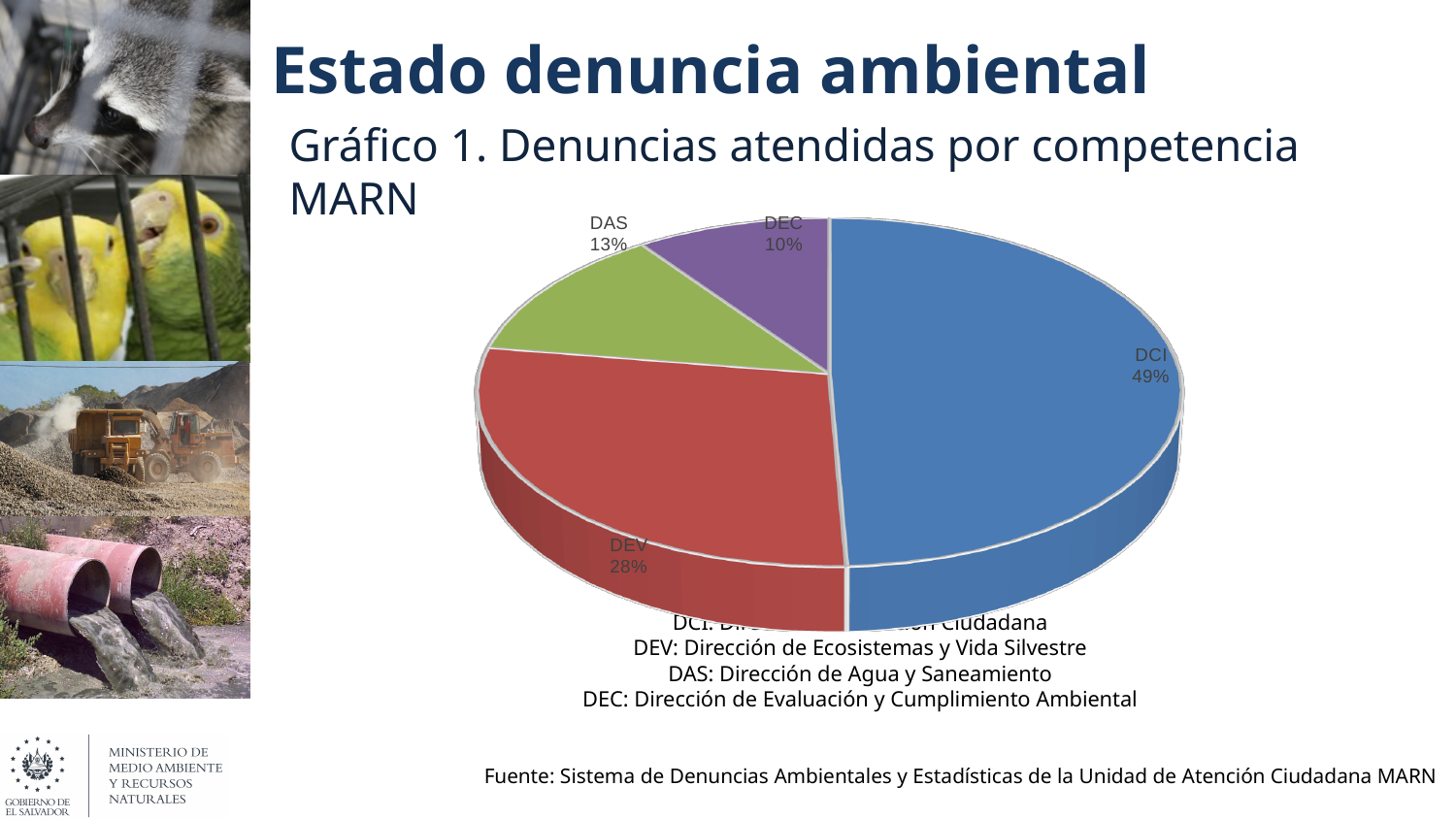
Which is larger, the share for DEV or the share for DAS? DEV What kind of chart is shown on the slide? Pie chart What share of the pie does DCI represent? 49% What is the difference in percentage points between DAS and DEC? 3 Which category has the largest slice of the pie? DCI What percentage is shown for DAS? 13% Which category has the smallest slice of the pie? DEC What percentage is shown for DEC? 10% What is the title of the chart? Gráfico 1. Denuncias atendidas por competencia MARN What is the difference in percentage points between DCI and DEV? 21 What percentage is shown for DEV? 28% How many slices does the pie chart have? 4